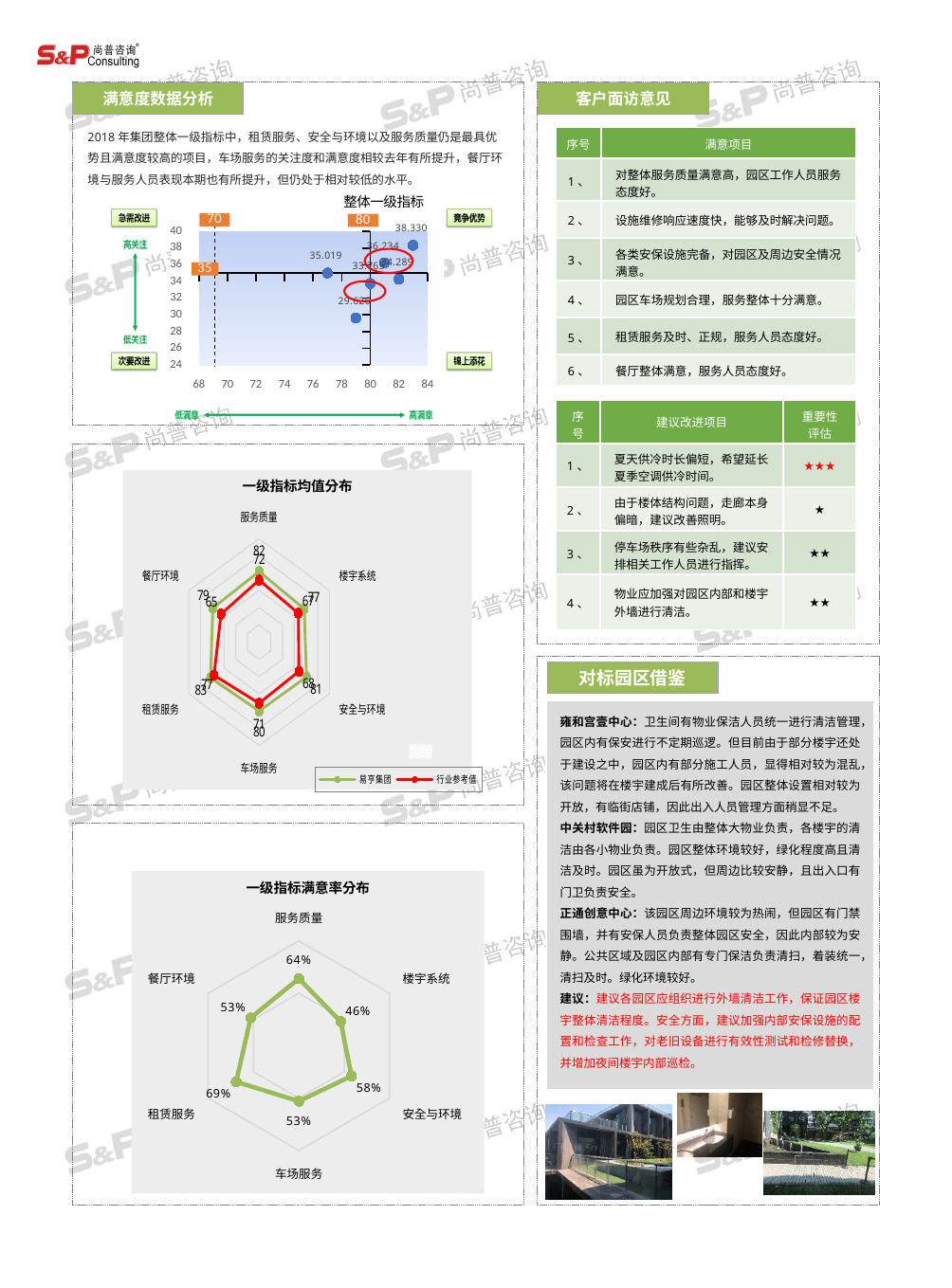
What kind of chart is the one titled 整体一级指标? Scatter chart In the chart titled 一级指标均值分布, which series has the larger value for 服务质量, 易享集团 or 行业参考值? 易享集团 In the chart titled 一级指标均值分布, what is the difference between 易享集团 and 行业参考值 for 安全与环境? 13 In the chart titled 一级指标均值分布, what is the value of 行业参考值 for 餐厅环境? 65 In the chart titled 整体一级指标, what is the data label of the highest point? 38.330 In the chart titled 一级指标满意率分布, which category has the lowest value? 楼宇系统 In the chart titled 一级指标满意率分布, what is the difference between the values for 租赁服务 and 楼宇系统? 23% In the chart titled 一级指标满意率分布, which category has the highest value? 租赁服务 In the chart titled 一级指标均值分布, what is the value of 易享集团 for 租赁服务? 83 In the chart titled 一级指标满意率分布, how many categories are plotted? 6 In the chart titled 一级指标均值分布, how many series does the legend list? 2 In the chart titled 一级指标满意率分布, what is the value for 服务质量? 64%